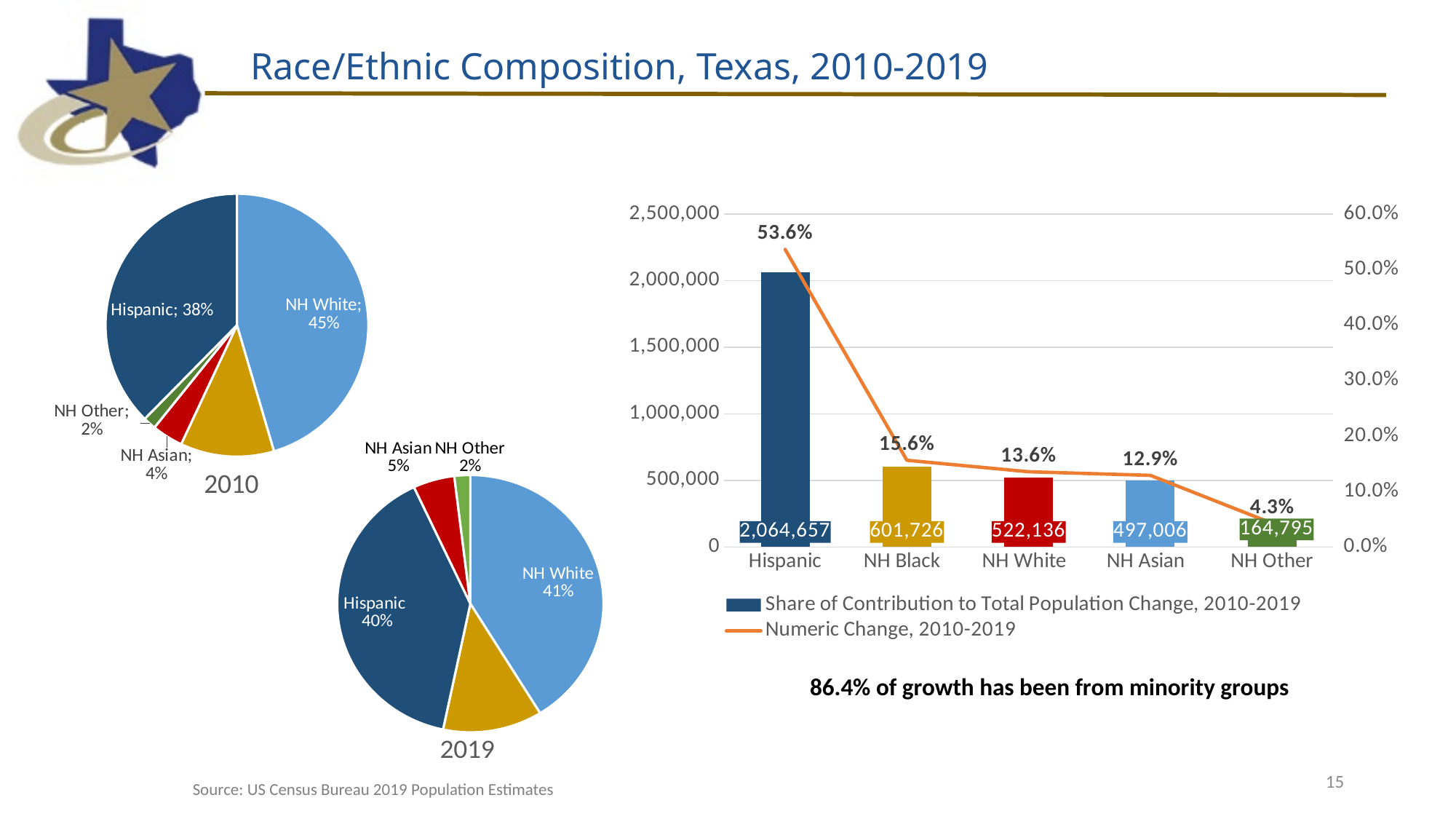
In the bar chart on the right, what is the numeric value shown for NH Black? 601,726 In the 2010 pie chart, what share is NH White? 45% In the 2010 pie chart, which labeled group has the smallest share? NH Other How many series does the legend of the chart on the right list? 2 In the chart on the right, which category has the highest bar? Hispanic In the 2010 pie chart, which labeled group has the largest share? NH White In the 2019 pie chart, what share is NH Asian? 5% In the chart on the right, what is the difference between the bar values for NH White and NH Asian? 25,130 By how many percentage points did the Hispanic share change between the 2010 and 2019 pie charts? 2 percentage points In the bar chart on the right, what is the numeric value shown for NH Other? 164,795 In the chart on the right, what percentage is shown on the line for NH White? 13.6% In the 2019 pie chart, what share is Hispanic? 40%